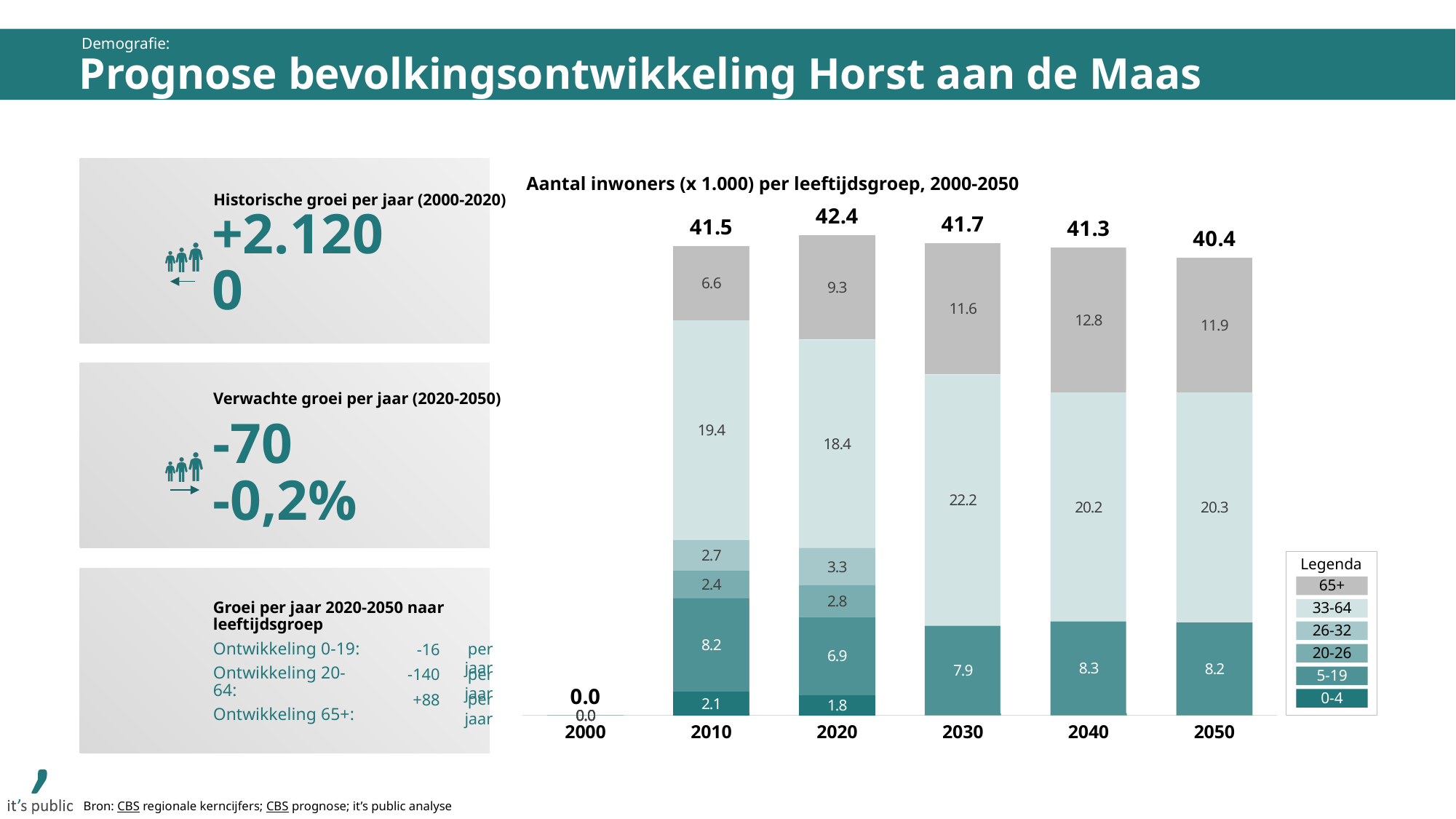
By how much does the 65+ value in 2020 exceed the 65+ value in 2010? 2.7 What is the value for the 65+ age group in 2010? 6.6 What is the value for the 0-4 age group in 2020? 1.8 What is the total number of inhabitants (x 1.000) shown for 2020? 42.4 Among the years 2010 to 2050, which year has the lowest total? 2050 Is the 65+ value larger in 2040 or in 2050? 2040 How many age groups does the legend list? 6 Which year has the highest total number of inhabitants? 2020 What is the title of the chart? Aantal inwoners (x 1.000) per leeftijdsgroep, 2000-2050 What kind of chart is shown on the slide? Stacked bar chart How many years are shown on the x axis of the chart? 6 What is the value for the 33-64 age group in 2020? 18.4